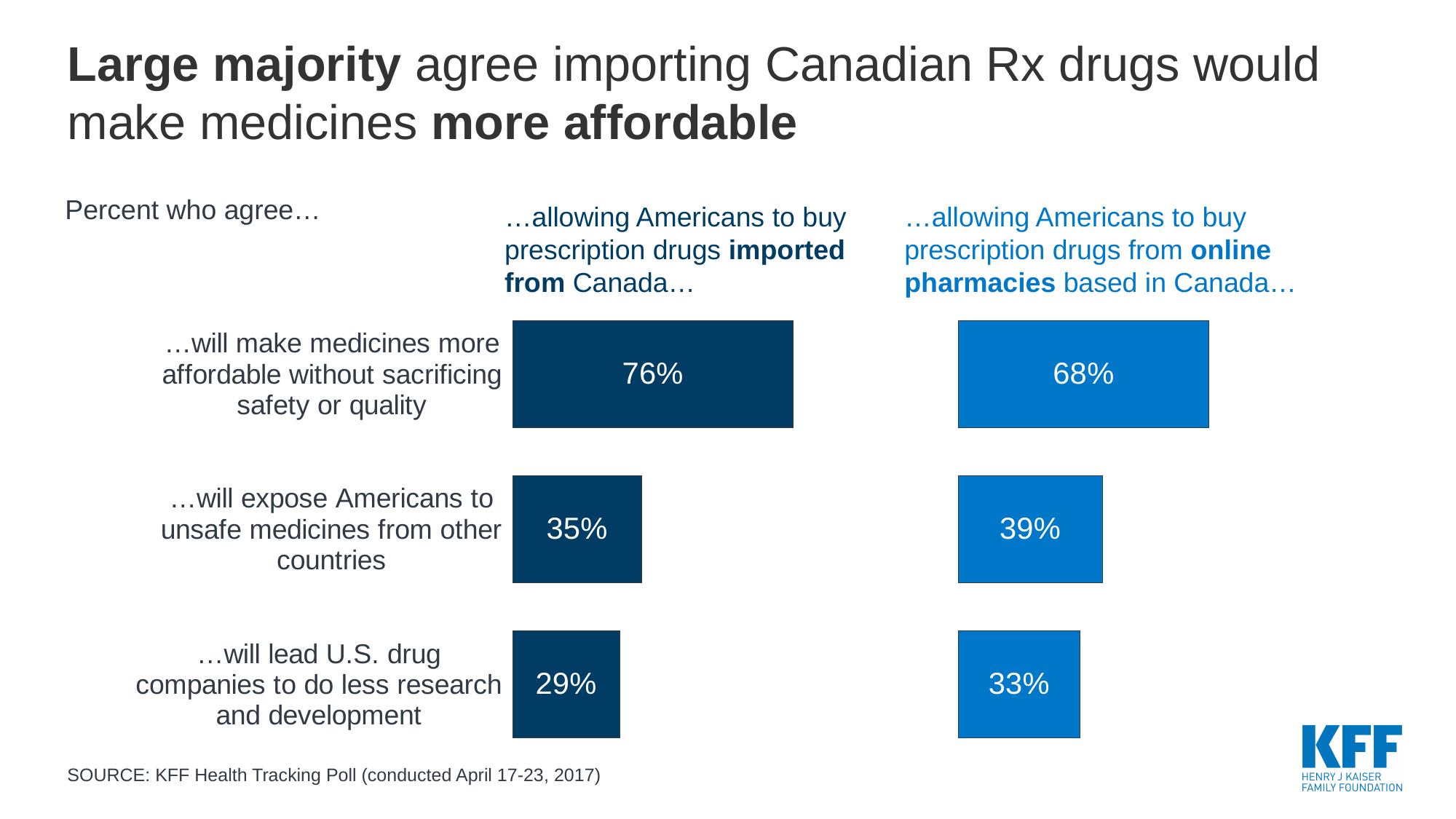
What is the difference between the percent agreeing that imported drugs will make medicines more affordable (76%) and the percent agreeing the same for online pharmacies (68%)? 8 percentage points What percent agree that allowing Americans to buy prescription drugs imported from Canada will make medicines more affordable without sacrificing safety or quality? 76% What kind of chart is shown on the slide? Bar chart Which statement has the lowest percent agreeing for drugs from online pharmacies based in Canada? …will lead U.S. drug companies to do less research and development What is the difference between the percent agreeing that imported drugs will lead to less research and development (29%) and the percent agreeing the same for online pharmacies (33%)? 4 percentage points What percent agree that allowing Americans to buy prescription drugs from online pharmacies based in Canada will lead U.S. drug companies to do less research and development? 33% What percent agree that allowing Americans to buy prescription drugs imported from Canada will expose Americans to unsafe medicines from other countries? 35% Which statement has the highest percent agreeing for drugs imported from Canada? …will make medicines more affordable without sacrificing safety or quality How many statements are shown in the chart? 3 How many series (policy scenarios) does the chart compare? 2 What percent agree that allowing Americans to buy prescription drugs from online pharmacies based in Canada will make medicines more affordable without sacrificing safety or quality? 68% Which is larger: the percent agreeing that imported drugs will expose Americans to unsafe medicines, or the percent agreeing the same for online pharmacies? Online pharmacies (39%)